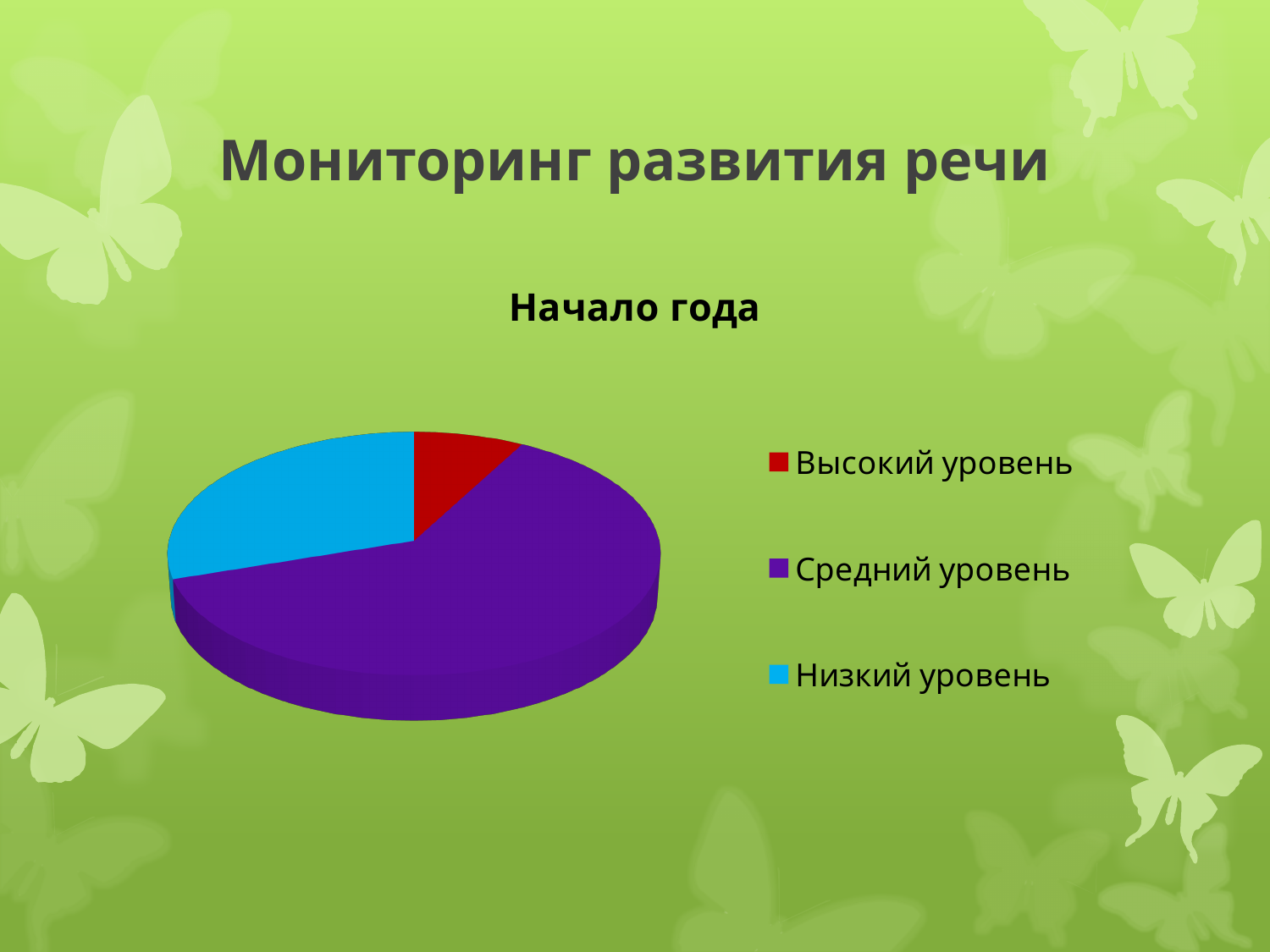
Which slice is larger, Средний уровень or Низкий уровень? Средний уровень Which category has the largest slice of the pie? Средний уровень How many slices does the pie chart have? 3 Which slice is larger, Высокий уровень or Низкий уровень? Низкий уровень What is the title of the chart? Начало года What kind of chart is shown on the slide? Pie chart Which category has the smallest slice of the pie? Высокий уровень What colour represents Низкий уровень in the chart? Blue How many entries does the legend list? 3 Which category is shown in red? Высокий уровень